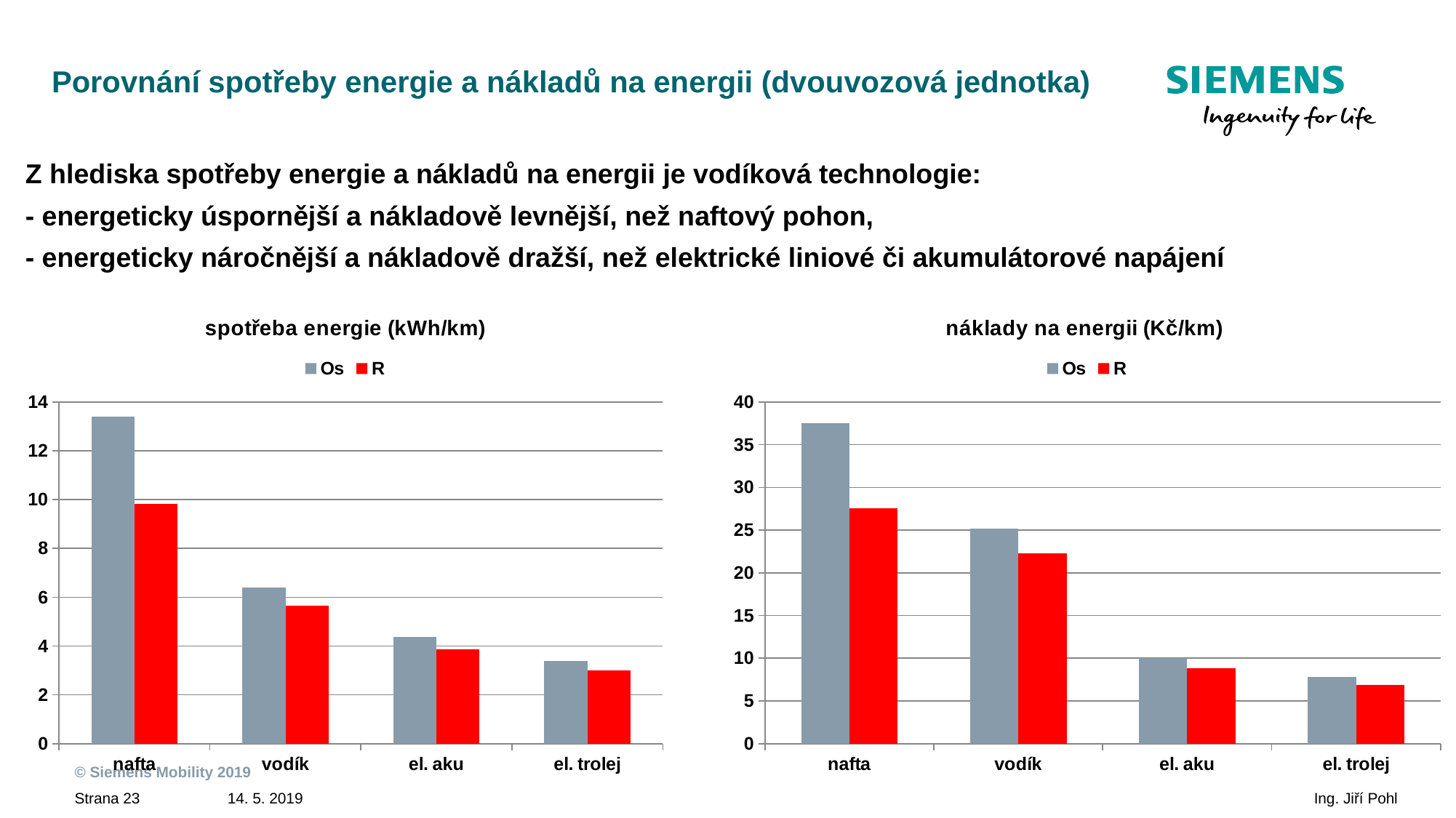
In the left chart "spotřeba energie (kWh/km)", which category has the highest value for the Os series? nafta In the right chart "náklady na energii (Kč/km)", is the Os value for vodík greater or less than 20? greater In the right chart "náklady na energii (Kč/km)", do the Os values rise or fall from nafta to el. trolej? fall What are the two legend entries in the right chart "náklady na energii (Kč/km)"? Os and R In the left chart "spotřeba energie (kWh/km)", is the Os value for nafta greater or less than 12? greater In the right chart "náklady na energii (Kč/km)", is the R value for nafta greater or less than 30? less In the left chart "spotřeba energie (kWh/km)", how many categories are shown on the x axis? 4 In the left chart "spotřeba energie (kWh/km)", which has the larger Os value: vodík or el. aku? vodík What kind of chart is the left chart titled "spotřeba energie (kWh/km)"? bar chart In the right chart "náklady na energii (Kč/km)", which category has the lowest value for the R series? el. trolej In the right chart "náklady na energii (Kč/km)", how many series does the legend list? 2